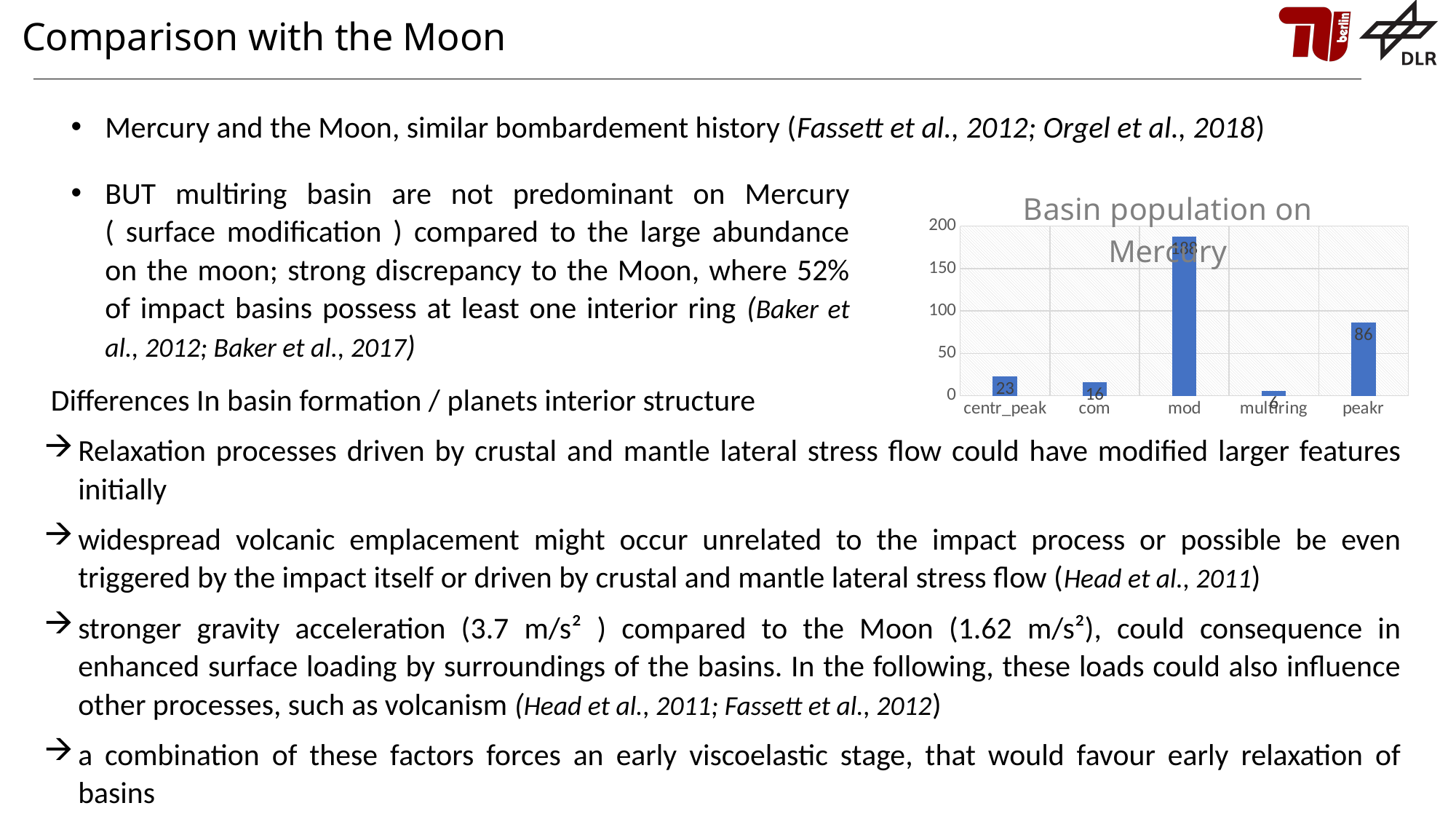
What is the value for com? 16 Is the value for mod greater or less than 150? greater Which category has the highest value? mod What is the title of the chart? Basin population on Mercury Is the value for multiring greater or less than 50? less How many categories are shown on the x axis of the chart? 5 What is the difference between the values for peakr and centr_peak? 63 What is the value for centr_peak? 23 Which is larger, the value for centr_peak or the value for com? centr_peak Which category has the lowest value? multiring What type of chart is shown on the slide? bar chart What is the value for peakr? 86